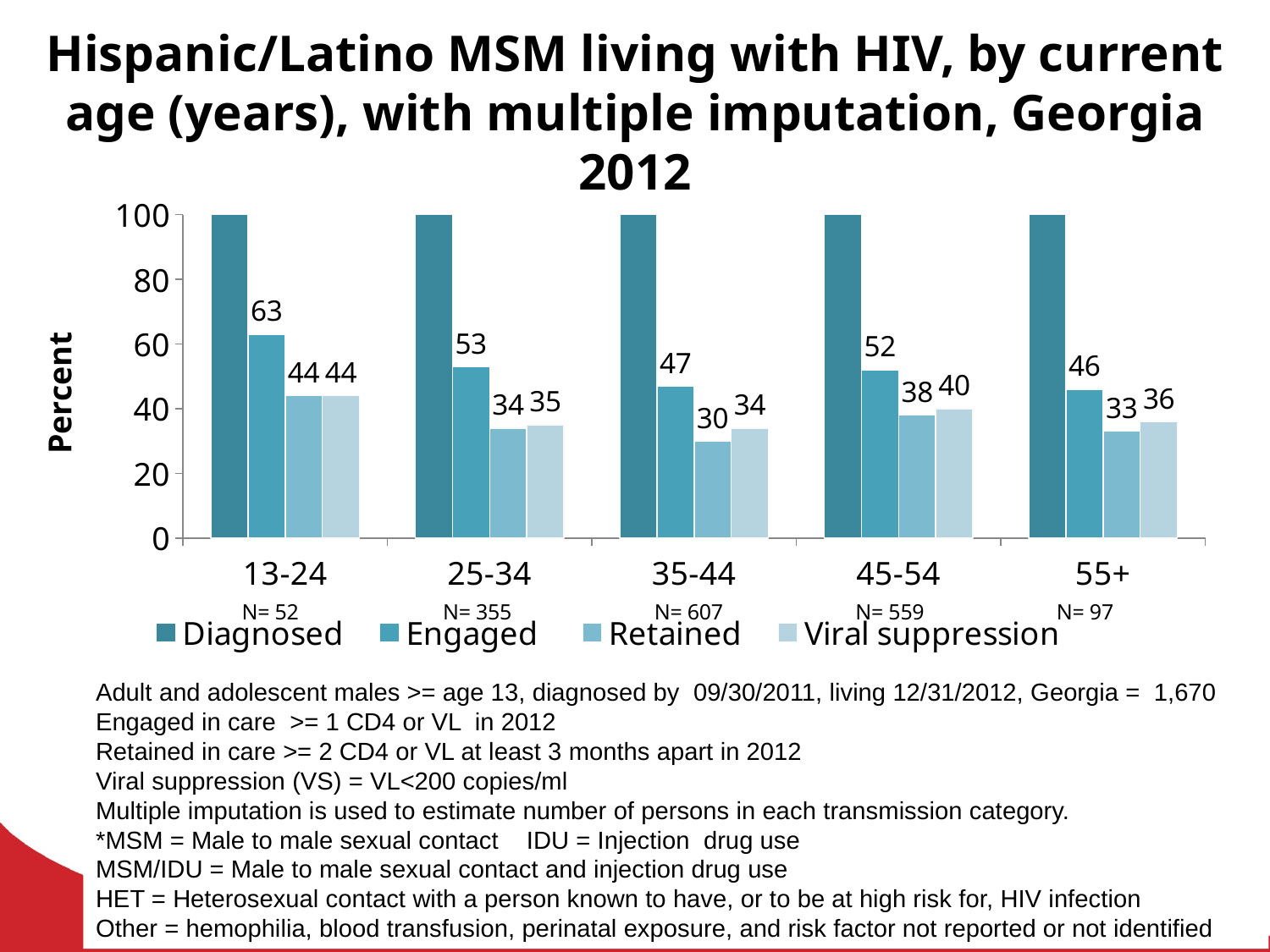
What is the Viral suppression value for the 45-54 age group? 40 How many series does the legend list? 4 How many age groups are shown on the x axis? 5 Which age group has the lowest Retained value? 35-44 What is the label on the y axis? Percent Which age group has the highest Engaged value? 13-24 What kind of chart is shown on the slide? bar chart What percent of Hispanic/Latino MSM aged 13-24 are Engaged in care? 63 Is the Engaged value for the 55+ age group greater or less than 60? less Is the Viral suppression value larger for the 13-24 group or the 55+ group? 13-24 What is the difference between the Engaged and Retained values for the 25-34 age group? 19 What is the Retained value for the 35-44 age group? 30